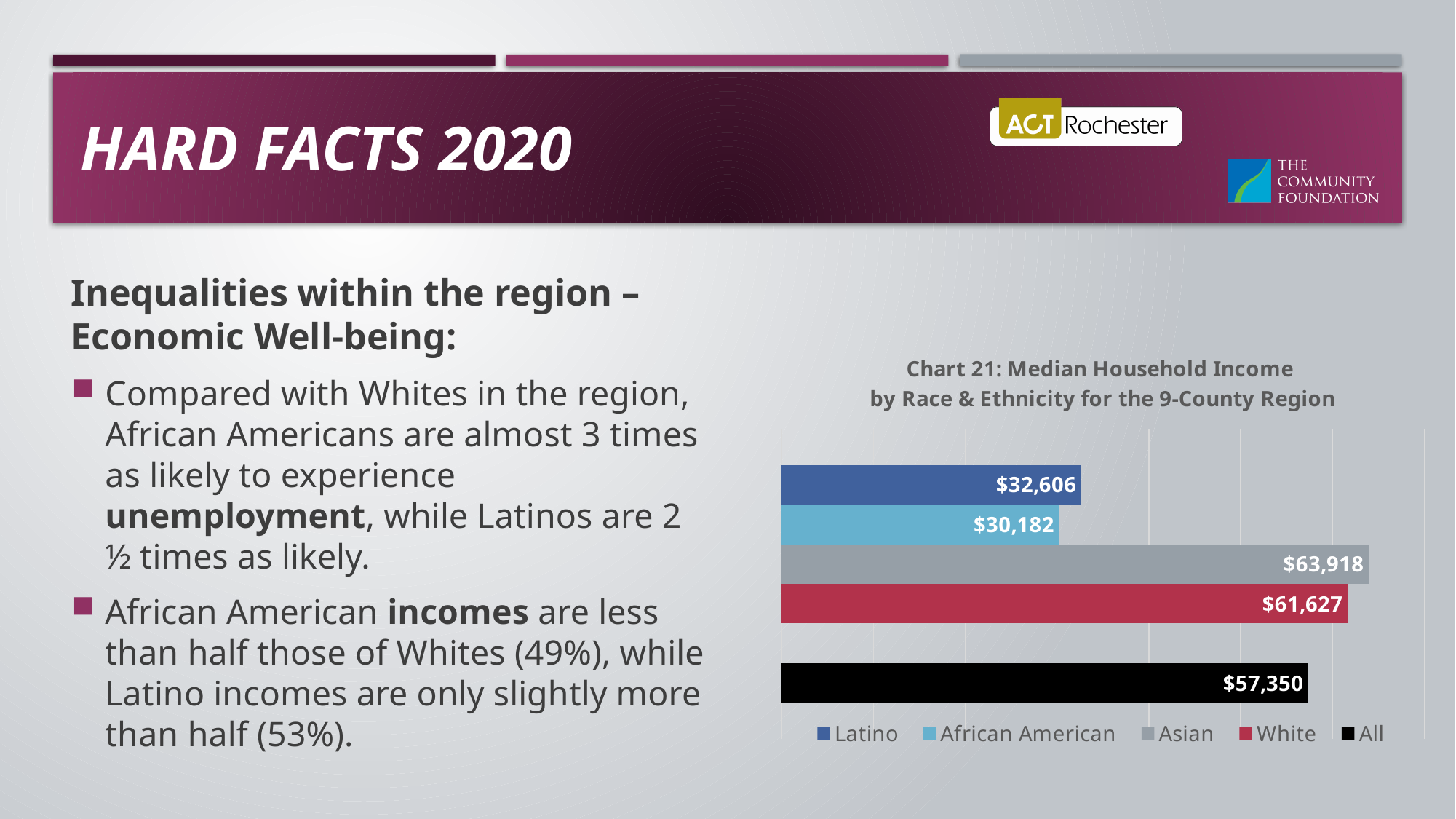
Which is larger in Chart 21, the median household income for All households or for White households? White Which group has the lowest median household income in Chart 21? African American How many groups does the legend of Chart 21 list? 5 What is the difference between the White and Latino median household incomes in Chart 21? $29,021 What is the median household income for African American households in Chart 21? $30,182 What is the difference between the Asian and White median household incomes in Chart 21? $2,291 What is the median household income for Asian households in Chart 21? $63,918 What is the median household income for White households in Chart 21? $61,627 What is the median household income for Latino households in Chart 21? $32,606 What kind of chart is Chart 21? Bar chart Which group has the highest median household income in Chart 21? Asian What is the median household income for All households in Chart 21? $57,350